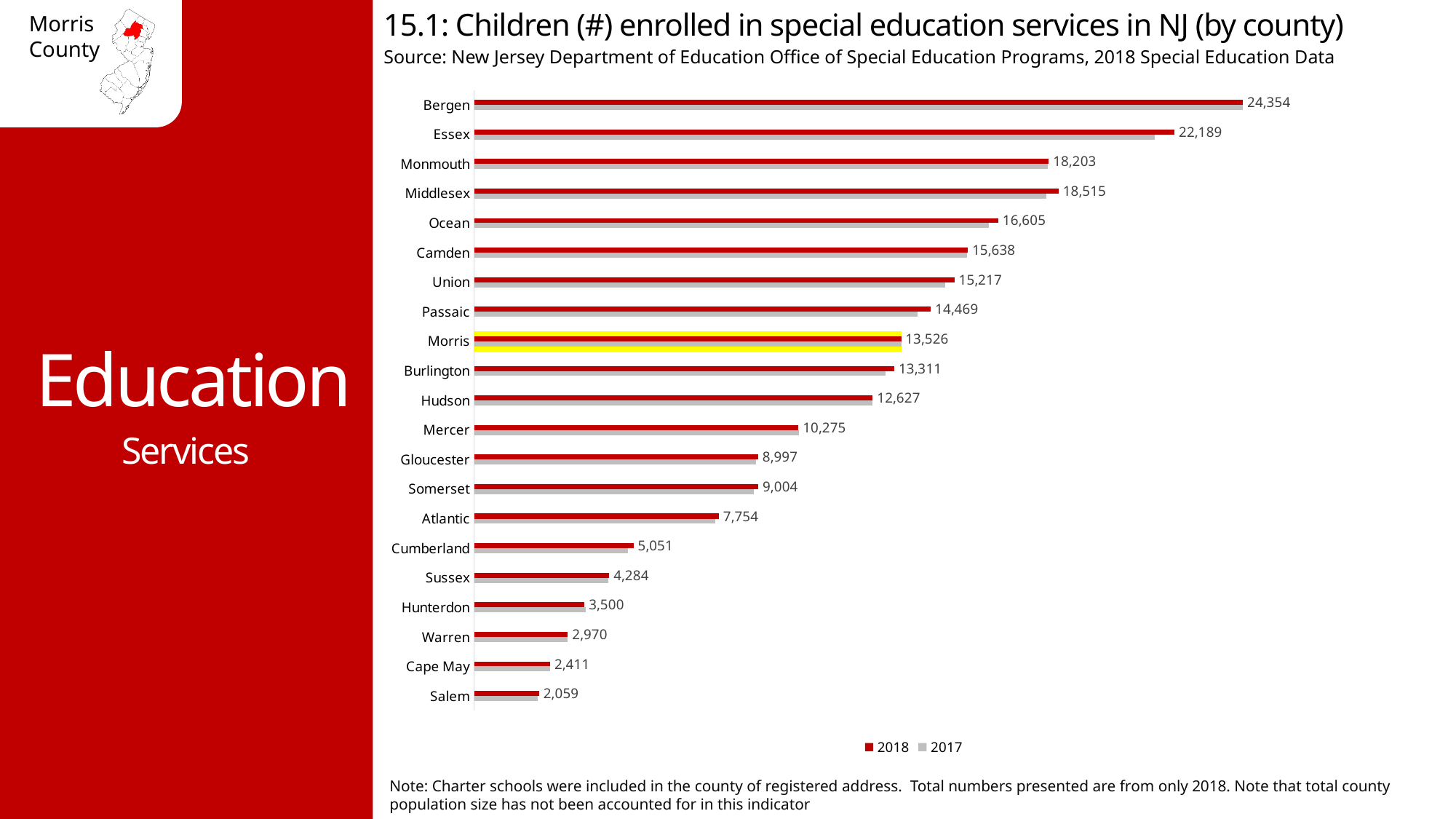
What kind of chart is shown on the slide? Bar chart How many children were enrolled in special education services in Bergen county in 2018? 24,354 What is the 2018 value shown for Hudson county? 12,627 How many counties are shown on the chart? 21 What is the difference between the 2018 values for Morris and Burlington? 215 What is the 2018 value shown for Salem county? 2,059 What is the 2018 value for Morris county? 13,526 How many series does the legend list? 2 What is the difference between the 2018 values for Bergen and Essex? 2,165 Which county has the lowest number of children enrolled in special education services in 2018? Salem Which county has the highest number of children enrolled in special education services in 2018? Bergen Which county has a larger 2018 value, Ocean or Camden? Ocean